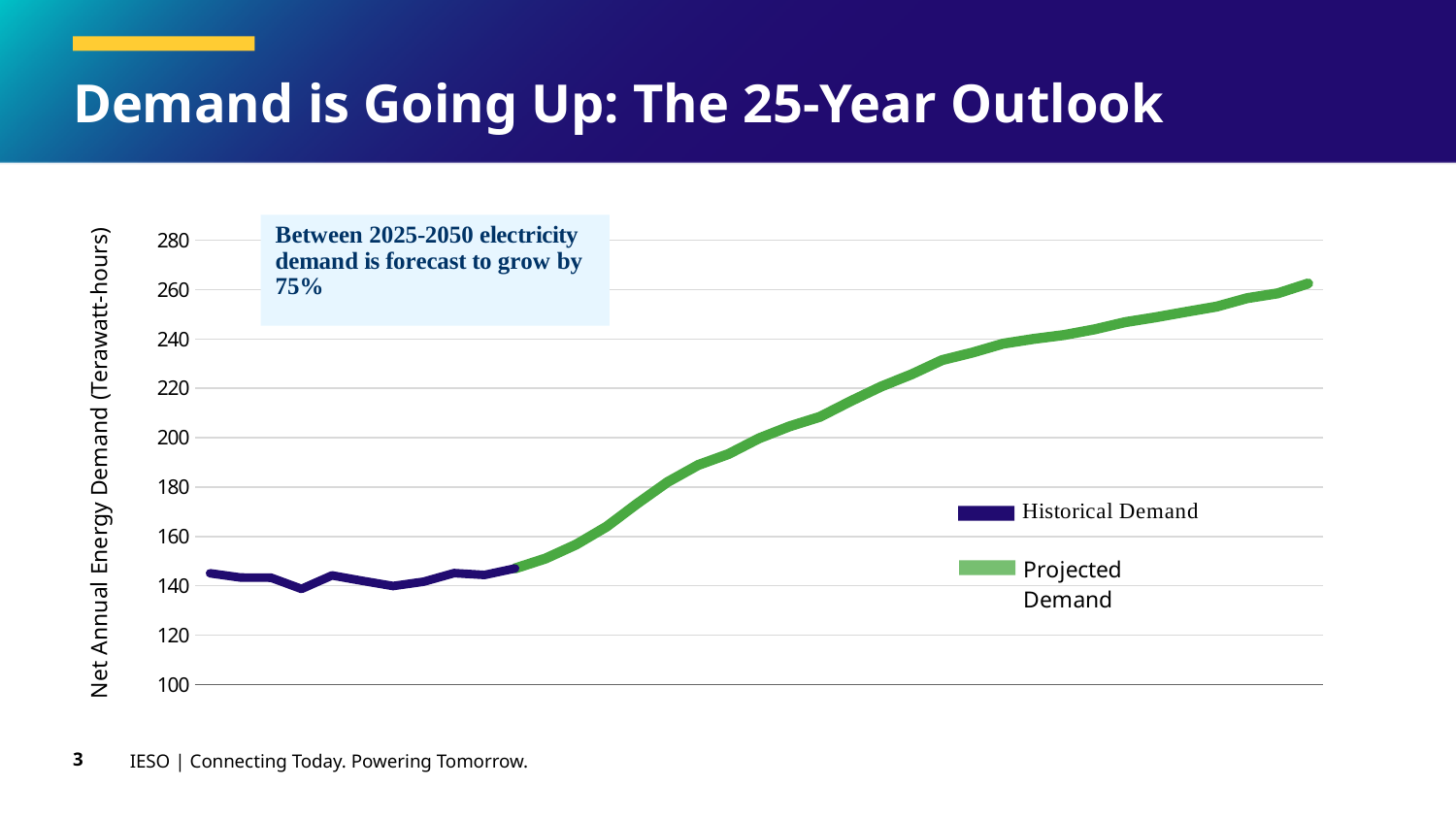
Is the highest point of the Projected Demand line greater or less than 280? less What is the label on the chart's vertical axis? Net Annual Energy Demand (Terawatt-hours) What is the lowest value shown on the chart's vertical axis? 100 How many series does the chart's legend list? 2 Is the Historical Demand line greater or less than 160 across its whole length? less Is the final value of the Projected Demand line greater or less than 240? greater Which series is shown in green in the chart? Projected Demand Which series reaches higher values on the chart, Historical Demand or Projected Demand? Projected Demand Does the Projected Demand line rise or fall along the x axis? Rise What kind of chart is shown on the slide? Line chart